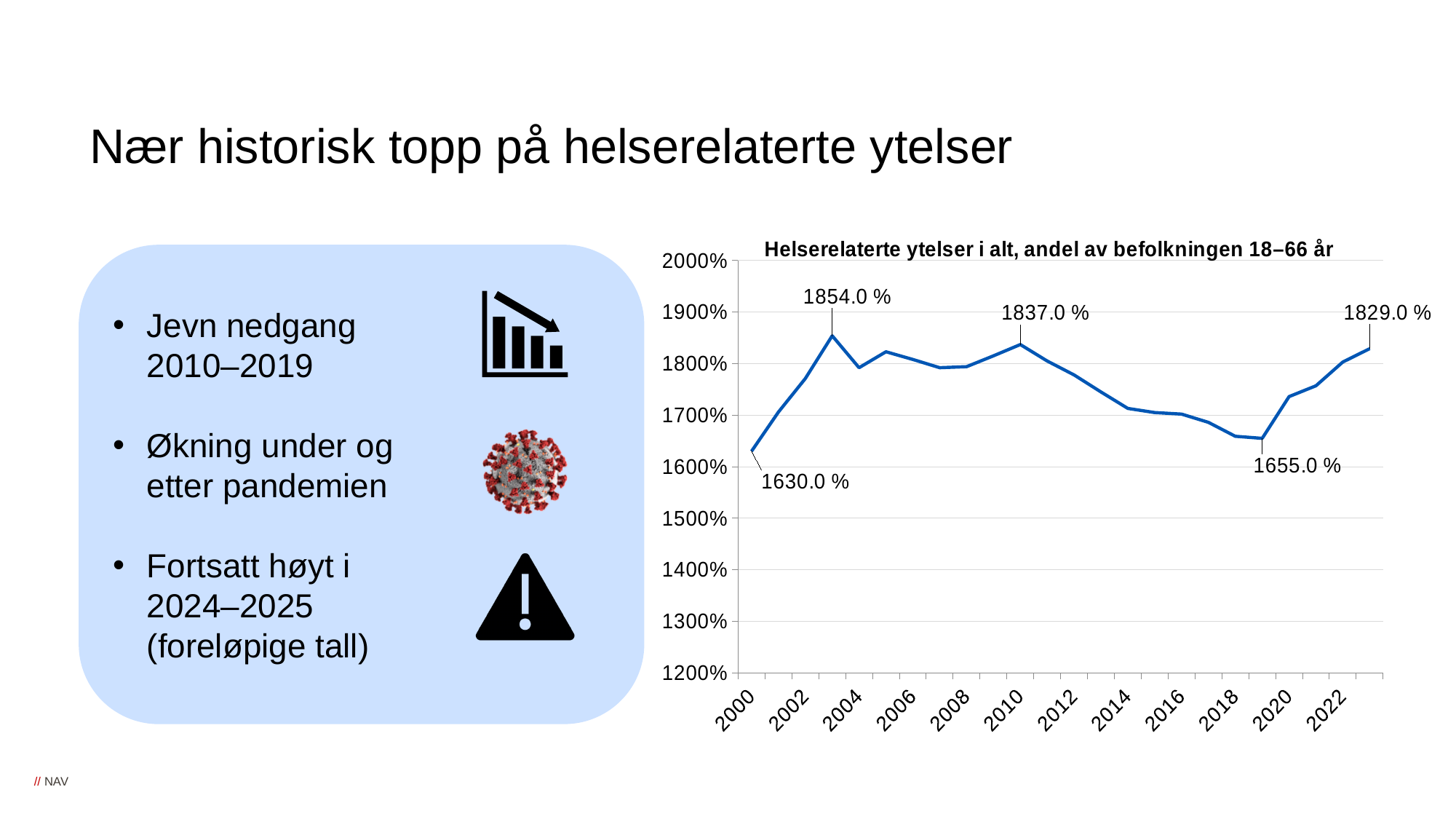
What value is labelled for the last point on the line (2023)? 1829.0 % What is the highest value labelled on the chart? 1854.0 % What is the title of the chart? Helserelaterte ytelser i alt, andel av befolkningen 18–66 år What value is labelled for the year 2000? 1630.0 % What value is labelled for the year 2019? 1655.0 % In which year does the line reach its highest point? 2003 What value is labelled for the year 2010? 1837.0 % Is the value for 2016 greater or less than 1800%? less What is the difference between the labelled values for 2010 and 2019? 182.0 % Which year has the larger value, 2010 or 2023? 2010 What kind of chart is shown on the slide? line chart What is the difference between the labelled values for 2003 and 2023? 25.0 %